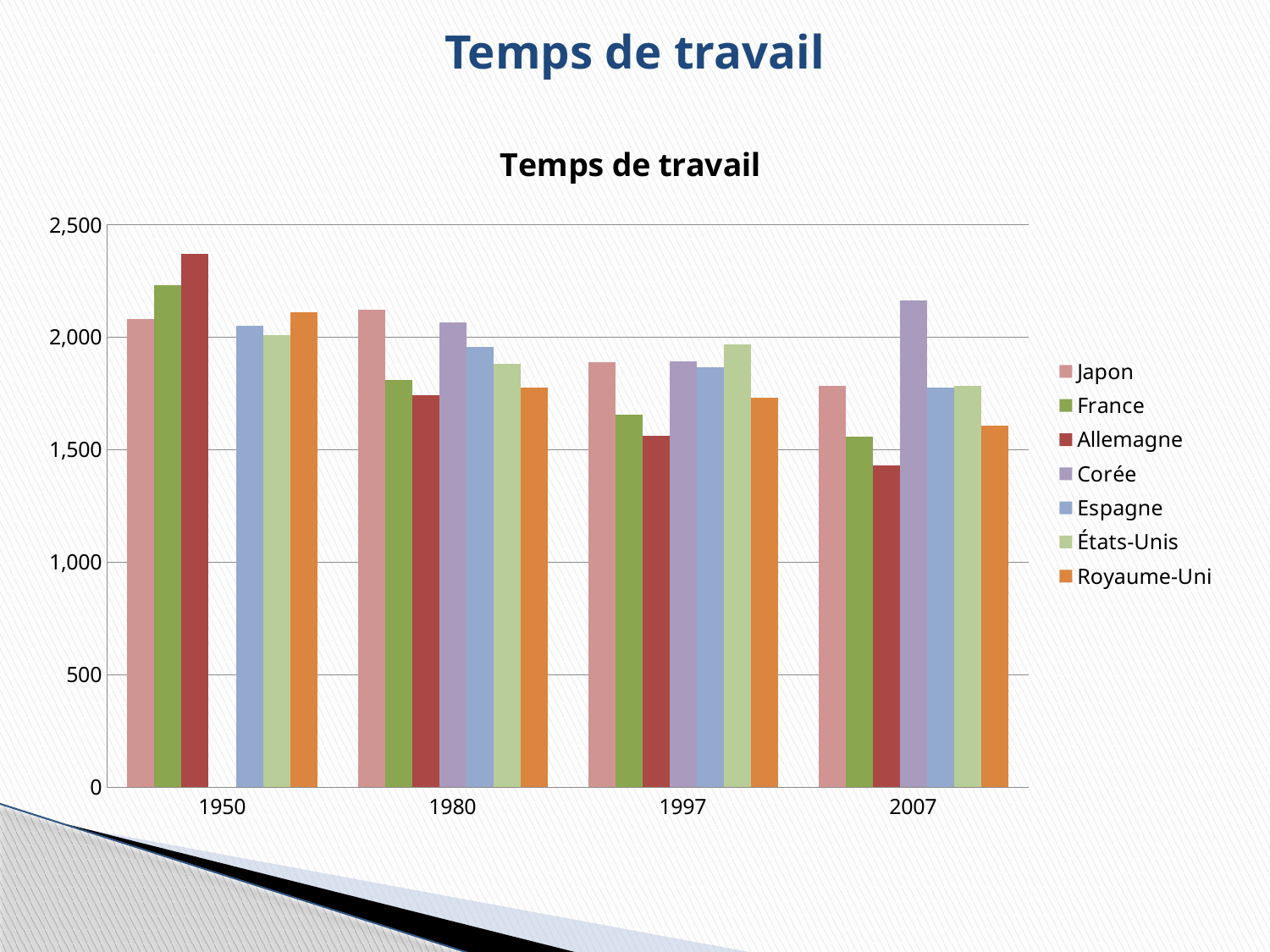
How many year categories are shown on the x axis? 4 Is the value for Allemagne in 2007 greater or less than 1,500? less Which series has no bar for 1950? Corée Which country has the highest value in 1950? Allemagne How many series does the legend list? 7 Which country has the highest value in 2007? Corée Does the value for Allemagne rise or fall from 1950 to 2007? fall What kind of chart is shown on the slide? bar chart Which country has the lowest value in 2007? Allemagne Is the value for Allemagne in 1950 greater or less than 2,000? greater Which country has the lowest value in 1997? Allemagne Is the value for Corée in 2007 greater or less than 2,000? greater